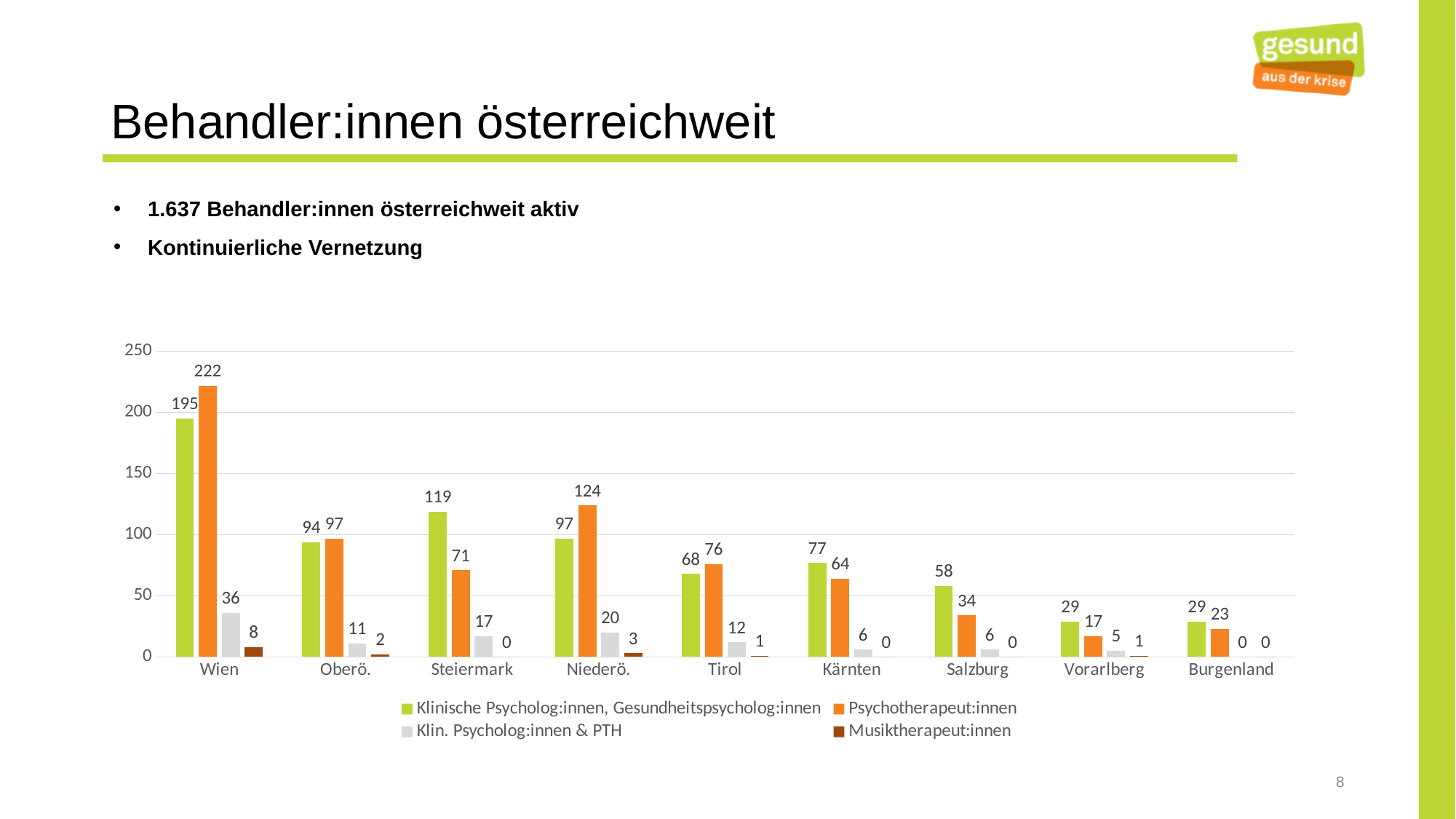
How many regions are shown on the x axis? 9 Which region has the lowest value for Klin. Psycholog:innen & PTH? Burgenland How many series does the legend list? 4 What is the value for Klin. Psycholog:innen & PTH in Niederö.? 20 What is the value for Klinische Psycholog:innen, Gesundheitspsycholog:innen in Steiermark? 119 Which region has the highest value for Psychotherapeut:innen? Wien Is the value for Psychotherapeut:innen in Steiermark greater or less than 100? less What is the value for Musiktherapeut:innen in Wien? 8 In Kärnten, which is larger: Klinische Psycholog:innen, Gesundheitspsycholog:innen or Psychotherapeut:innen? Klinische Psycholog:innen, Gesundheitspsycholog:innen What is the value for Psychotherapeut:innen in Wien? 222 What kind of chart is shown on the slide? bar chart What is the difference between the Psychotherapeut:innen and Klinische Psycholog:innen, Gesundheitspsycholog:innen values in Niederö.? 27